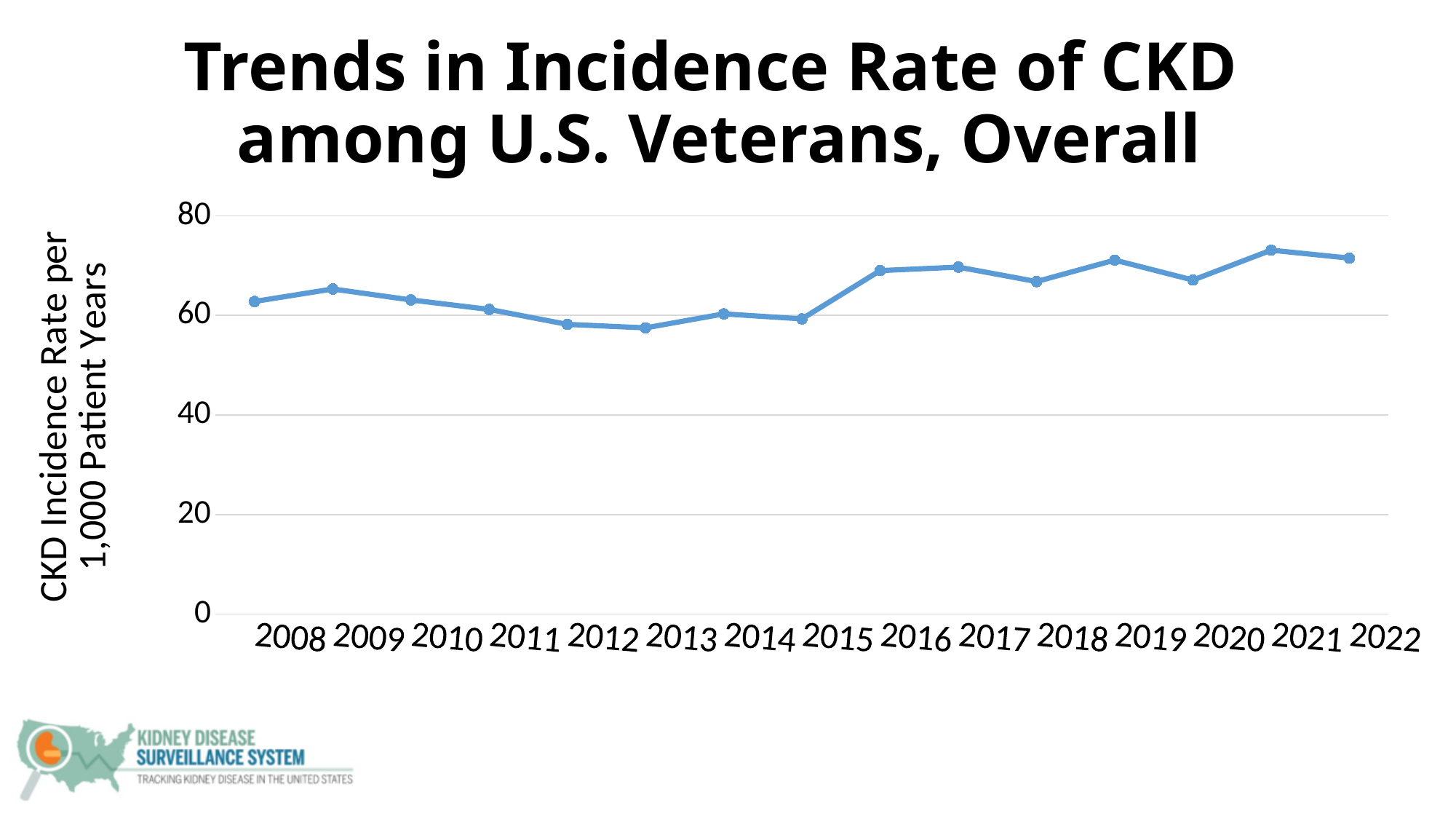
How many years (data points) are plotted on the chart? 15 Is the CKD incidence rate for 2021 greater or less than 70? greater Which year has the highest CKD incidence rate on the chart? 2021 What is the title of the chart? Trends in Incidence Rate of CKD among U.S. Veterans, Overall What kind of chart is shown on the slide? line chart Which year has the larger CKD incidence rate, 2009 or 2011? 2009 Is the CKD incidence rate for 2013 greater or less than 60? less Does the CKD incidence rate rise or fall from 2009 to 2013? fall Which year has the larger CKD incidence rate, 2012 or 2016? 2016 Is the CKD incidence rate for 2008 greater or less than 60? greater What is the label on the vertical axis of the chart? CKD Incidence Rate per 1,000 Patient Years